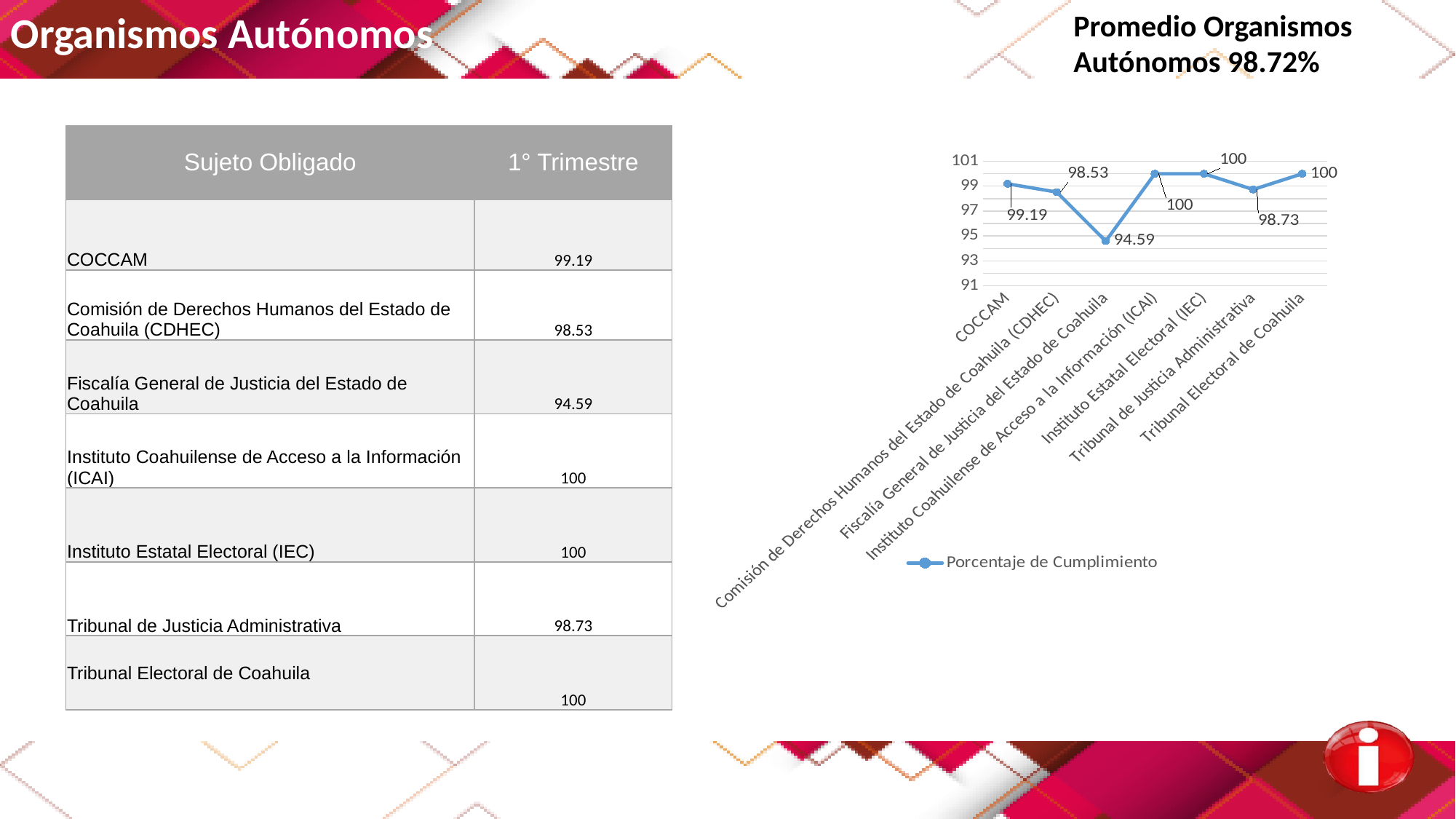
What is the value for Comisión de Derechos Humanos del Estado de Coahuila (CDHEC) in the chart? 98.53 How many series does the chart legend list? 1 Which is larger, the value for COCCAM or the value for Tribunal de Justicia Administrativa? COCCAM What type of chart is shown on the slide? line chart What is the value for COCCAM in the chart? 99.19 Is the value for Fiscalía General de Justicia del Estado de Coahuila greater or less than 95? less What is the name of the series shown in the chart legend? Porcentaje de Cumplimiento What is the difference between the values for COCCAM and Fiscalía General de Justicia del Estado de Coahuila? 4.6 Which category has the lowest value in the chart? Fiscalía General de Justicia del Estado de Coahuila What is the value for Tribunal de Justicia Administrativa in the chart? 98.73 How many categories are plotted in the chart? 7 What is the value for Fiscalía General de Justicia del Estado de Coahuila in the chart? 94.59